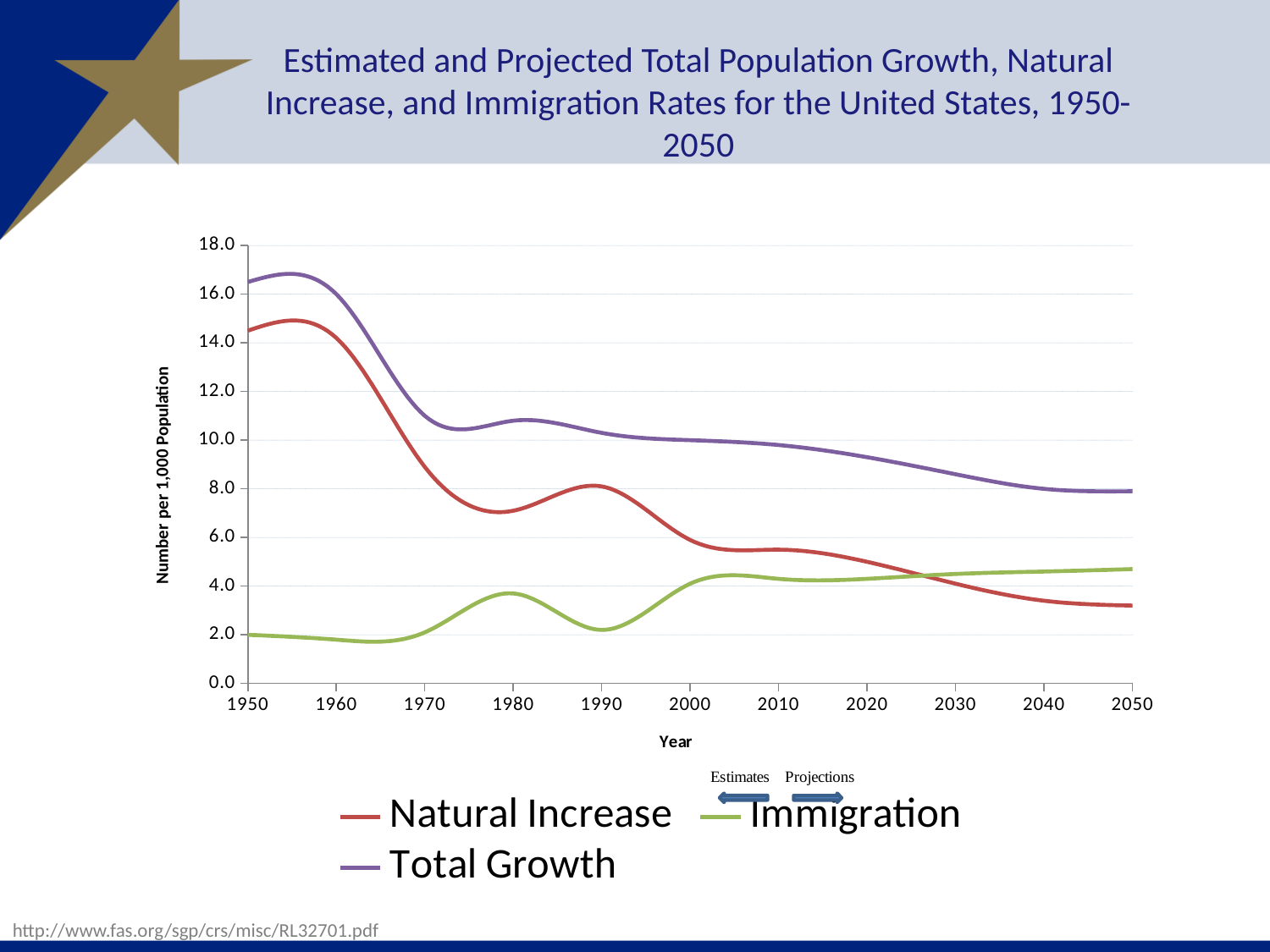
Does the Total Growth line rise or fall from 1950 to 2050? Fall Is the value for Immigration in 1990 greater or less than 3.0? less Is the value for Natural Increase in 1950 greater or less than 14.0? greater Which series has the highest value in 2000? Total Growth How many year labels are shown along the x axis? 11 What is the label on the y axis? Number per 1,000 Population Is the value for Total Growth in 1950 greater or less than 16.0? greater What kind of chart is shown on the slide? Line chart How many series does the legend list? 3 Which series has the lowest value in 1950? Immigration In 2050, which is larger: Immigration or Natural Increase? Immigration